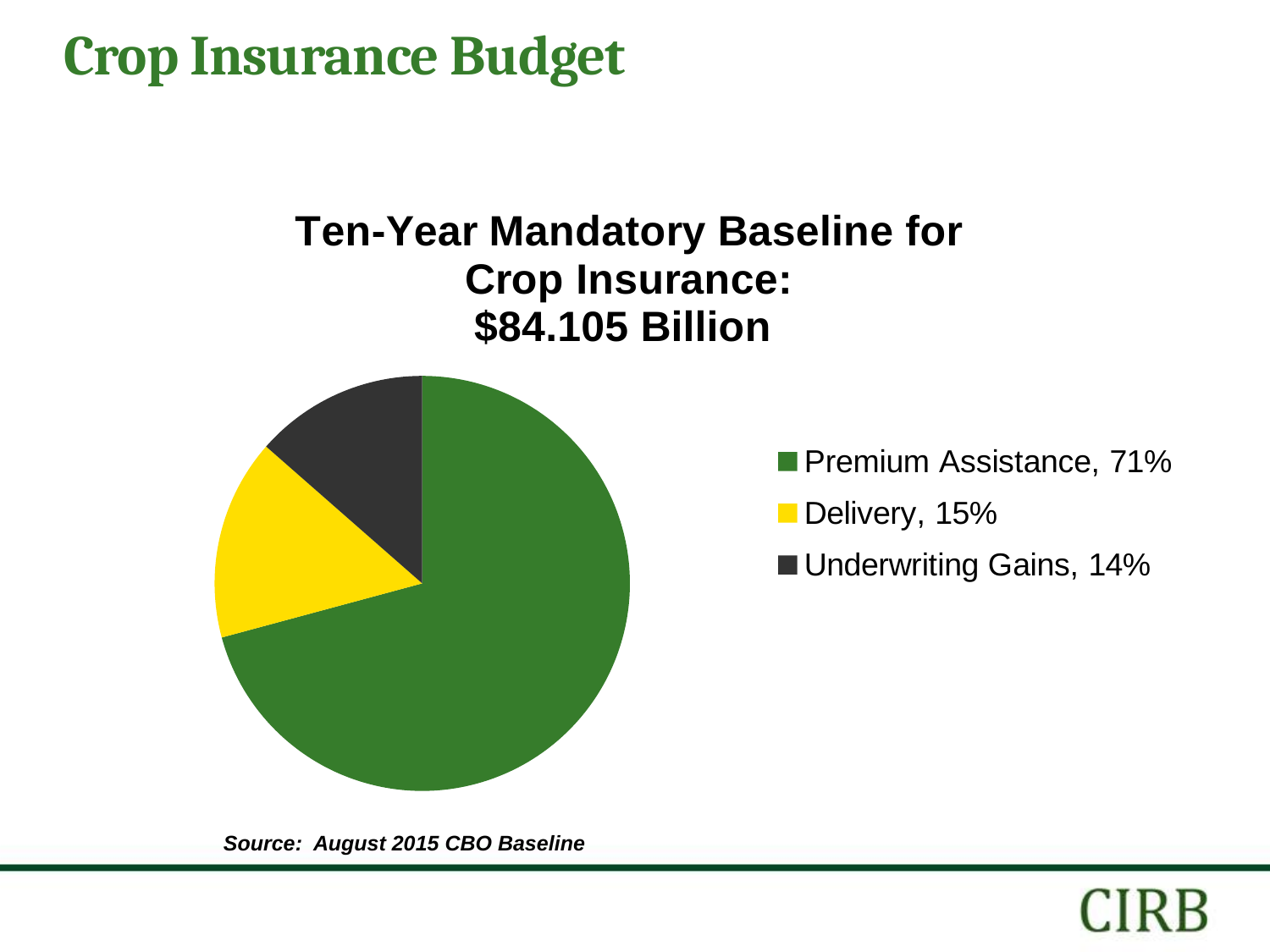
Which category has the largest slice of the pie? Premium Assistance What share of the pie does Delivery represent? 15% How many entries does the legend list? 3 What share of the pie does Premium Assistance represent? 71% Which is larger, the Premium Assistance slice or the Underwriting Gains slice? Premium Assistance What share of the pie does Underwriting Gains represent? 14% What total dollar amount does the chart title give for the ten-year mandatory baseline for crop insurance? $84.105 Billion What colour is the Delivery slice in the pie chart? yellow What is the difference in percentage points between Delivery and Underwriting Gains? 1 What is the difference in percentage points between Premium Assistance and Delivery? 56 What kind of chart is shown on the slide? pie chart How many slices does the pie chart have? 3